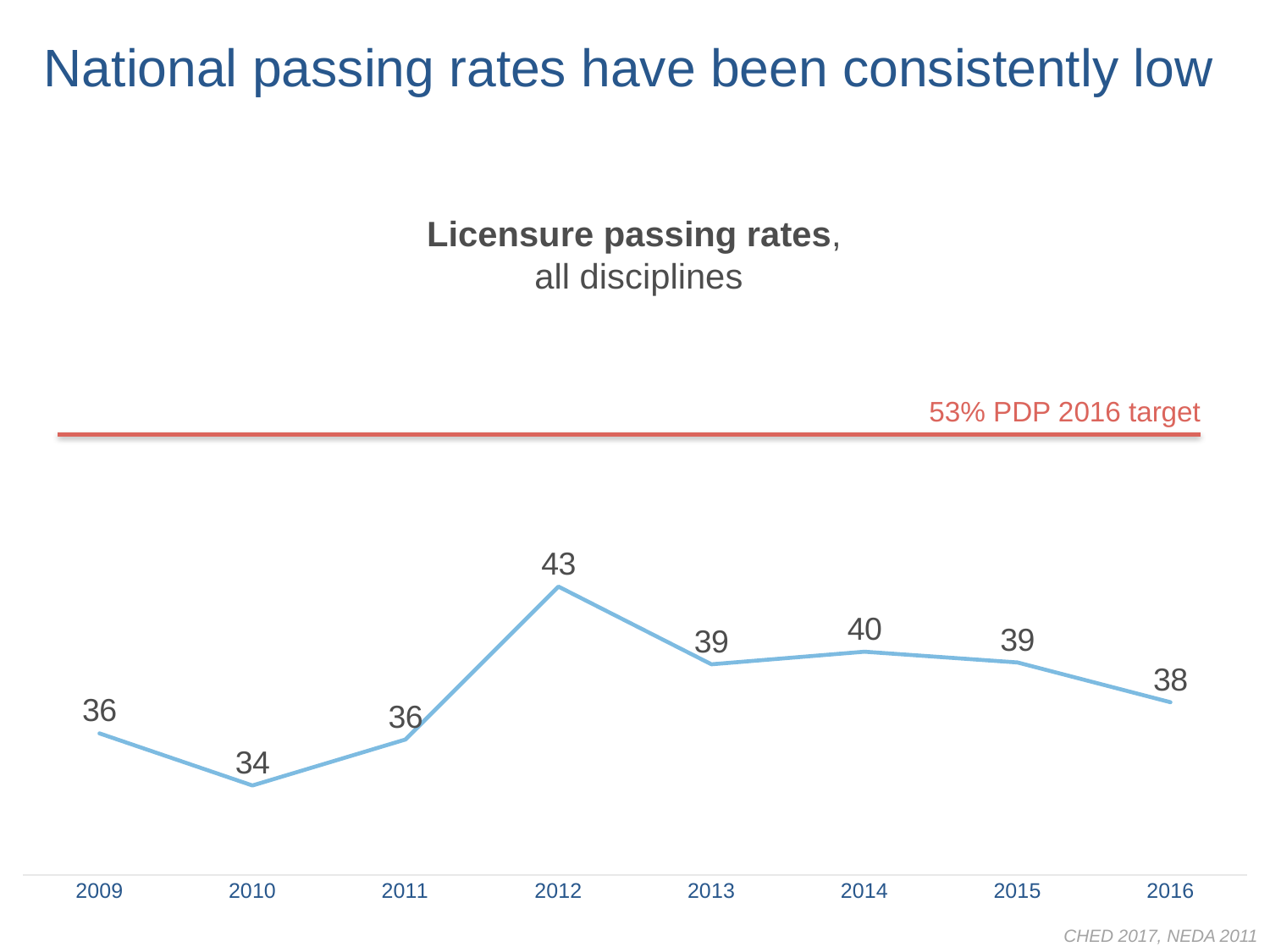
What is the title of the chart? Licensure passing rates, all disciplines What is the difference between the passing rate in 2012 and the passing rate in 2010? 9 Did the licensure passing rate rise or fall from 2012 to 2016? Fall What was the licensure passing rate in 2010? 34 Which year had the lowest licensure passing rate? 2010 What was the licensure passing rate in 2016? 38 How many years are plotted on the chart? 8 What kind of chart is shown on the slide? Line chart What was the licensure passing rate in 2012? 43 What is the PDP 2016 target passing rate shown by the red line? 53% Which year had a higher passing rate, 2014 or 2016? 2014 Which year had the highest licensure passing rate? 2012